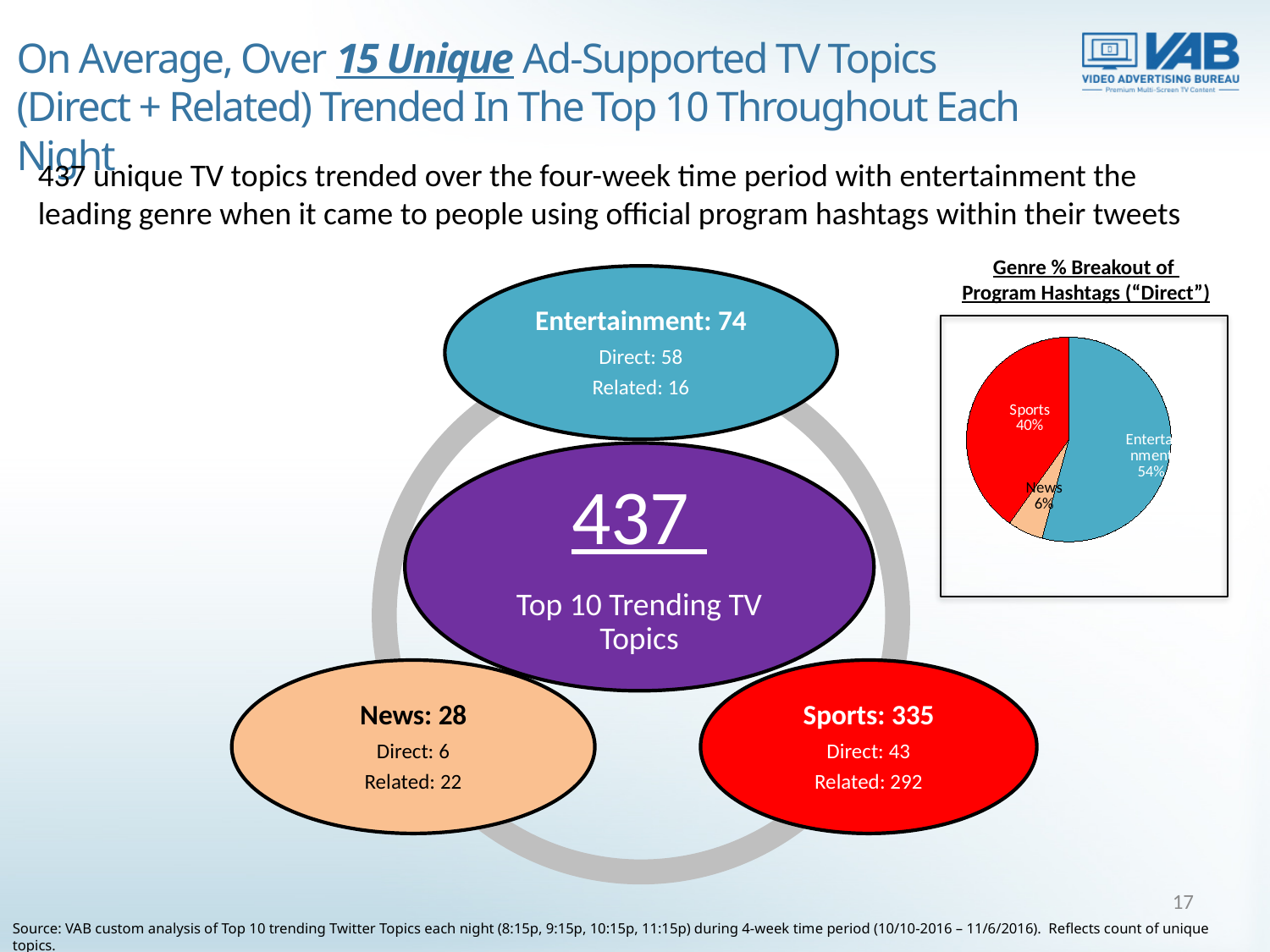
What type of chart is shown under the title "Genre % Breakout of Program Hashtags ("Direct")"? pie chart In the pie chart, what share of program hashtags is News? 6% How many slices does the pie chart have? 3 In the pie chart, how many percentage points larger is the Entertainment share than the Sports share? 14 What is the title of the pie chart? Genre % Breakout of Program Hashtags ("Direct") What colour is the Sports slice in the pie chart? red Which genre has the largest slice in the pie chart? Entertainment In the pie chart, which is larger: the Sports share or the Entertainment share? Entertainment In the pie chart, what share of program hashtags is Sports? 40% In the pie chart, how many percentage points larger is the Sports share than the News share? 34 In the pie chart, what share of program hashtags is Entertainment? 54% Which genre has the smallest slice in the pie chart? News